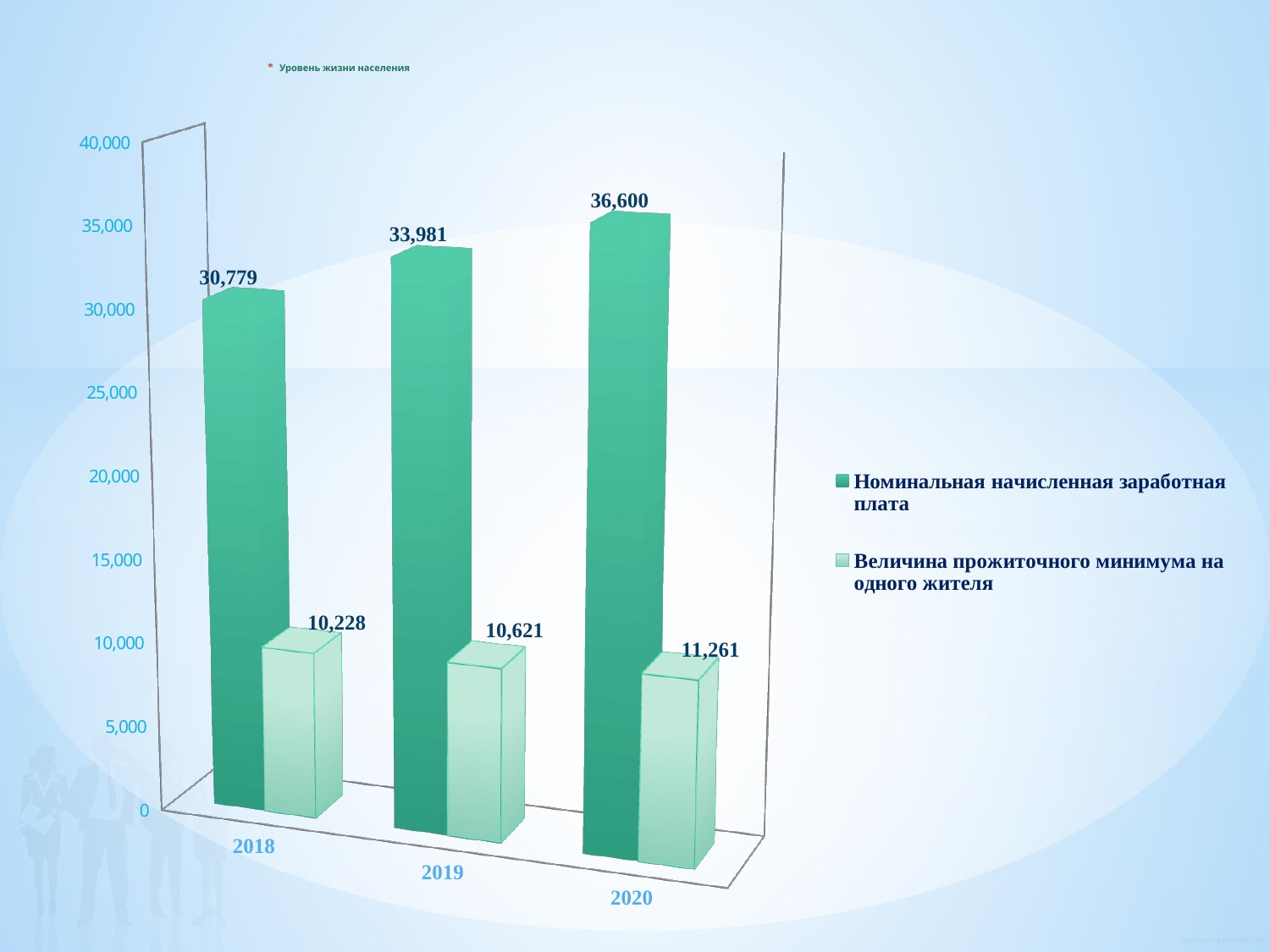
What was the subsistence minimum per resident (Величина прожиточного минимума на одного жителя) in 2020? 11,261 What was the nominal accrued wage (Номинальная начисленная заработная плата) in 2019? 33,981 In which year was the nominal accrued wage highest? 2020 In which year was the subsistence minimum per resident lowest? 2018 By how much did the nominal accrued wage increase from 2018 to 2020? 5,821 How many years are shown on the x axis? 3 Which is larger: the subsistence minimum in 2019 or in 2020? 2020 What is the difference between the nominal accrued wage and the subsistence minimum in 2019? 23,360 What was the nominal accrued wage in 2018? 30,779 How many series does the legend list? 2 Does the nominal accrued wage rise or fall from 2018 to 2020? Rises What kind of chart is shown on the slide? Bar chart